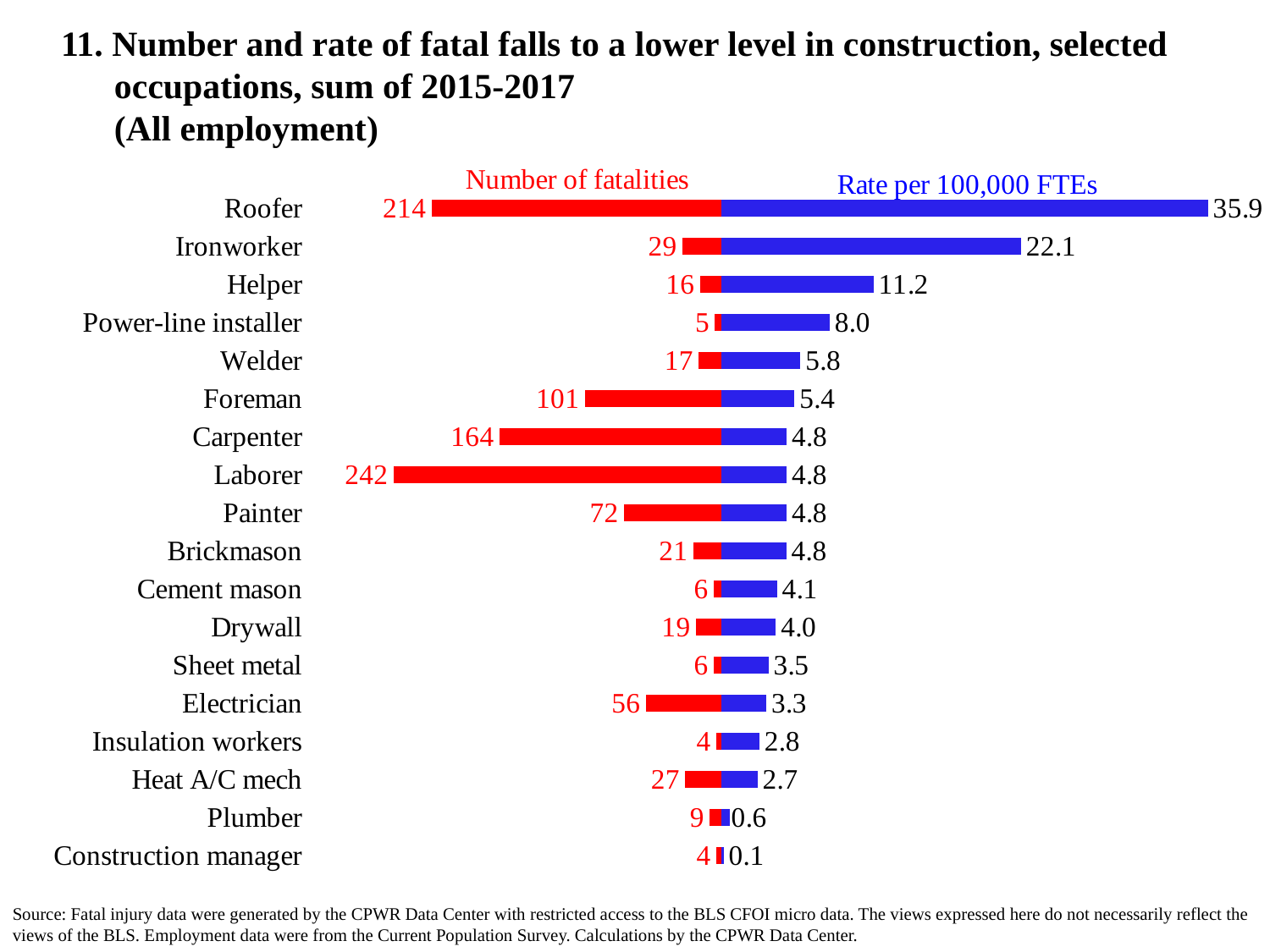
What is the number of fatalities for Roofer? 214 What is the difference in rate per 100,000 FTEs between Roofer and Ironworker? 13.8 Which occupation has the highest rate per 100,000 FTEs? Roofer Which occupation has the lowest rate per 100,000 FTEs? Construction manager What is the number of fatalities for Laborer? 242 What is the rate per 100,000 FTEs for Electrician? 3.3 What is the rate per 100,000 FTEs for Ironworker? 22.1 What is the difference in number of fatalities between Laborer and Roofer? 28 How many occupations are shown in the chart? 18 Which occupation has the highest number of fatalities? Laborer Which has more fatalities, Carpenter or Foreman? Carpenter What type of chart is shown on the slide? Bar chart